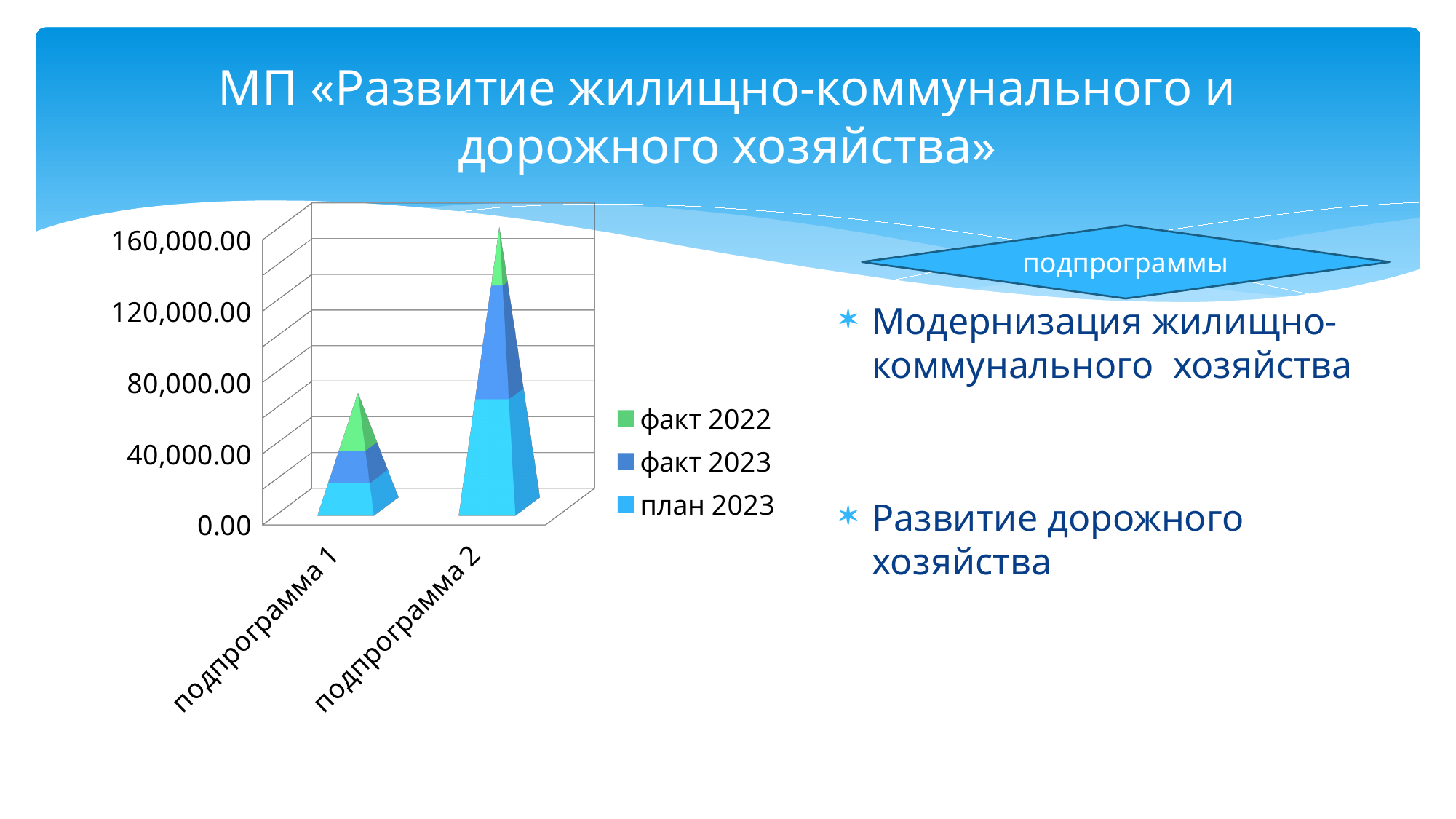
Which category has the lowest total value in the chart? подпрограмма 1 How many series does the chart legend list? 3 What kind of chart is shown on the slide? bar chart What is the highest value labelled on the vertical axis of the chart? 160,000.00 Which series is shown in green in the chart legend? факт 2022 How many categories are shown on the x axis of the chart? 2 Is the total stacked value for подпрограмма 2 greater or less than 120,000.00? greater Which category has the highest total value in the chart? подпрограмма 2 Which category has the taller stacked bar, подпрограмма 1 or подпрограмма 2? подпрограмма 2 Is the total stacked value for подпрограмма 1 greater or less than 40,000.00? greater Is the total stacked value for подпрограмма 1 greater or less than 80,000.00? less